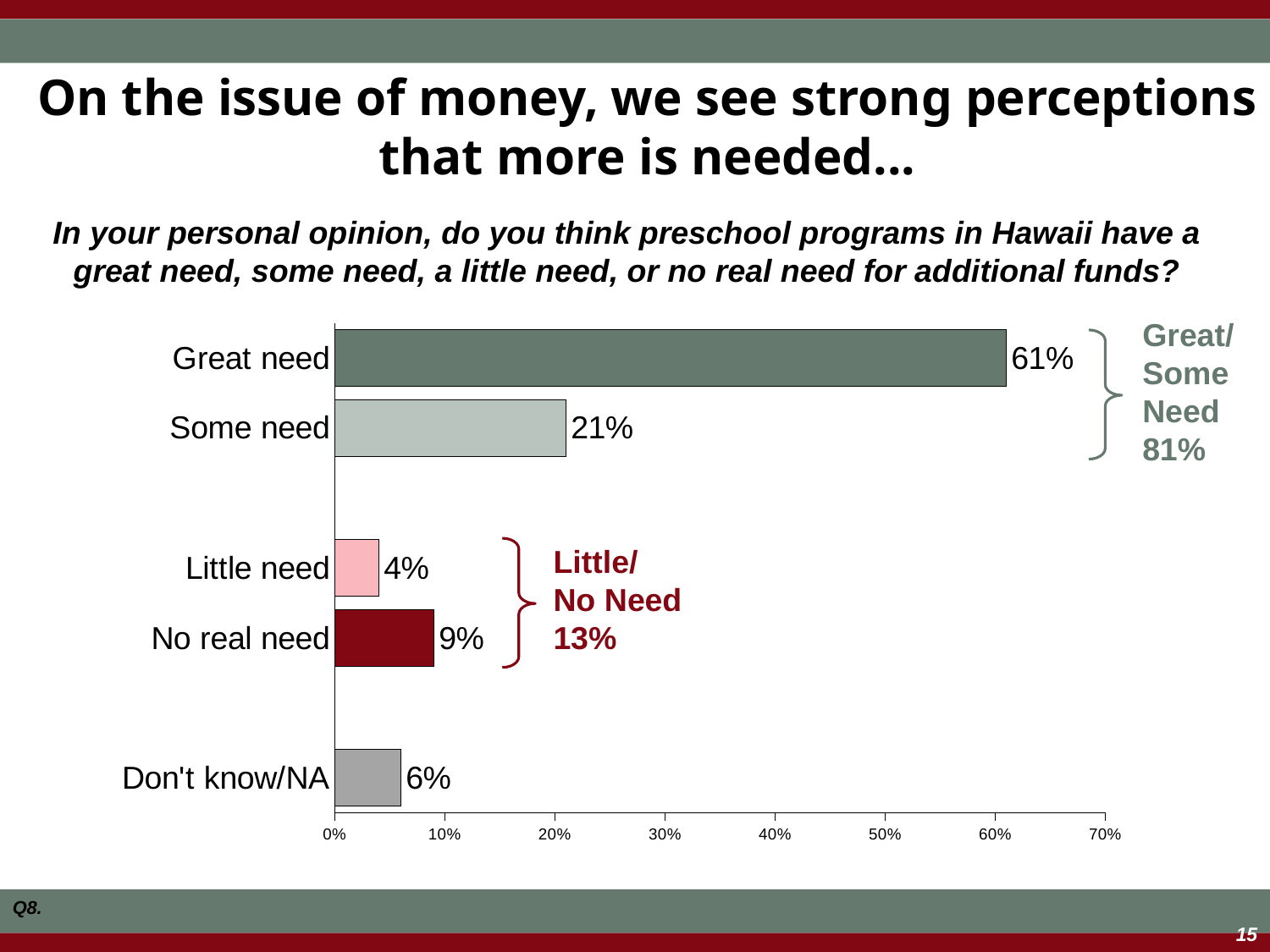
How many categories are shown in the chart? 5 Which category has the highest value in the chart? Great need Which is larger, the value for "No real need" or the value for "Little need"? No real need What is the value shown for "Some need"? 21% What is the value shown for "Don't know/NA"? 6% What is the difference between the "Great need" and "Some need" values? 40 percentage points What percentage of respondents said preschool programs in Hawaii have a great need for additional funds? 61% Is the value for "Great need" greater or less than 50%? greater What kind of chart is shown on the slide? Bar chart What combined percentage is shown for "Little/No Need"? 13% Which category has the lowest value in the chart? Little need What combined percentage is shown for "Great/Some Need"? 81%